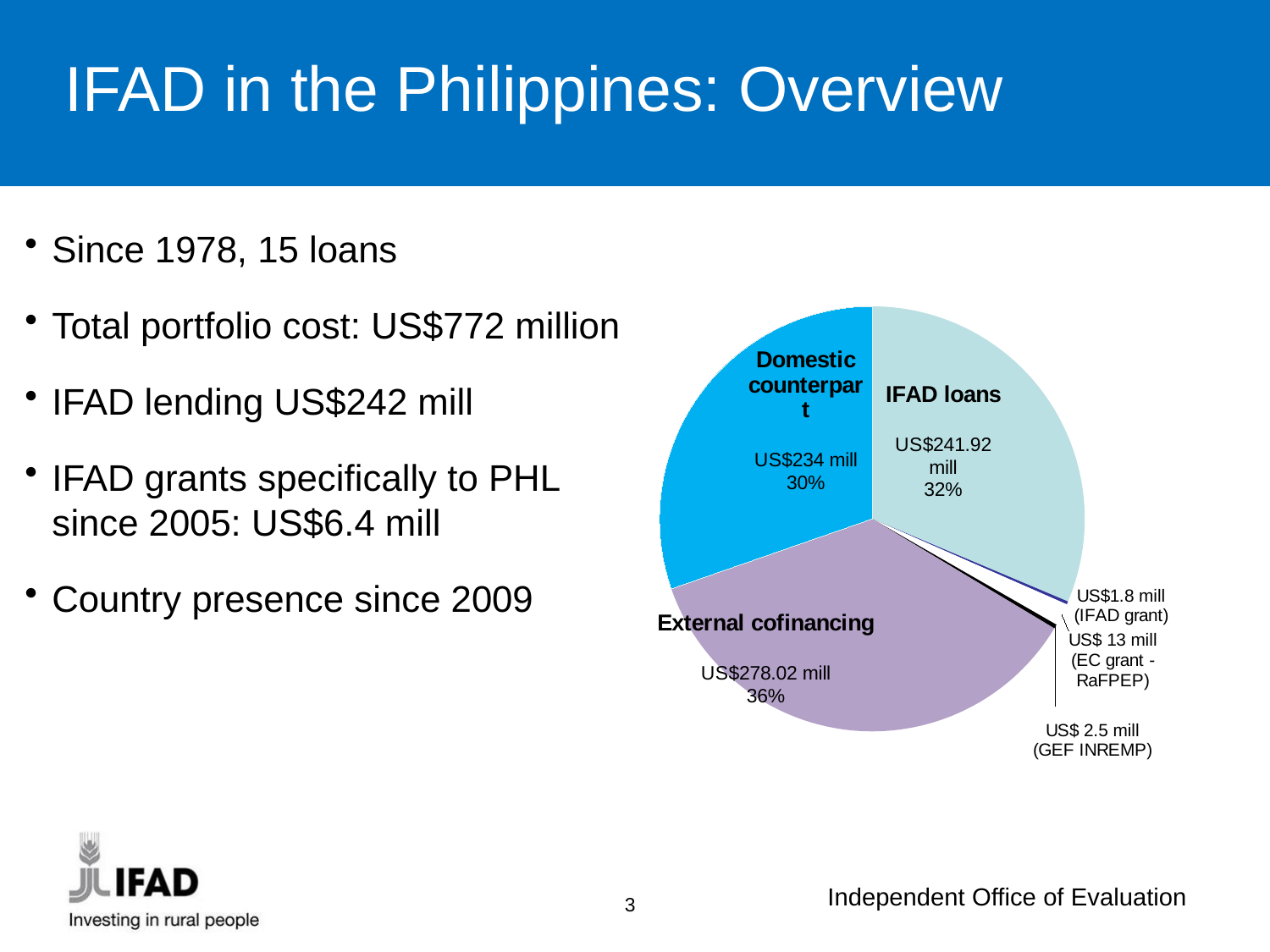
What is the value shown for the Domestic counterpart slice? US$234 mill What is the value shown for the External cofinancing slice? US$278.02 mill What share of the pie does Domestic counterpart represent? 30% What is the value shown for the IFAD loans slice? US$241.92 mill What share of the pie does External cofinancing represent? 36% What kind of chart is shown on the slide? Pie chart How many slices does the pie chart have? 6 What is the difference in percentage points between the External cofinancing share and the Domestic counterpart share? 6 percentage points What is the value shown for the GEF INREMP slice? US$ 2.5 mill Which slice of the pie is the smallest? US$1.8 mill (IFAD grant) What is the value shown for the EC grant - RaFPEP slice? US$ 13 mill Which slice of the pie is the largest? External cofinancing